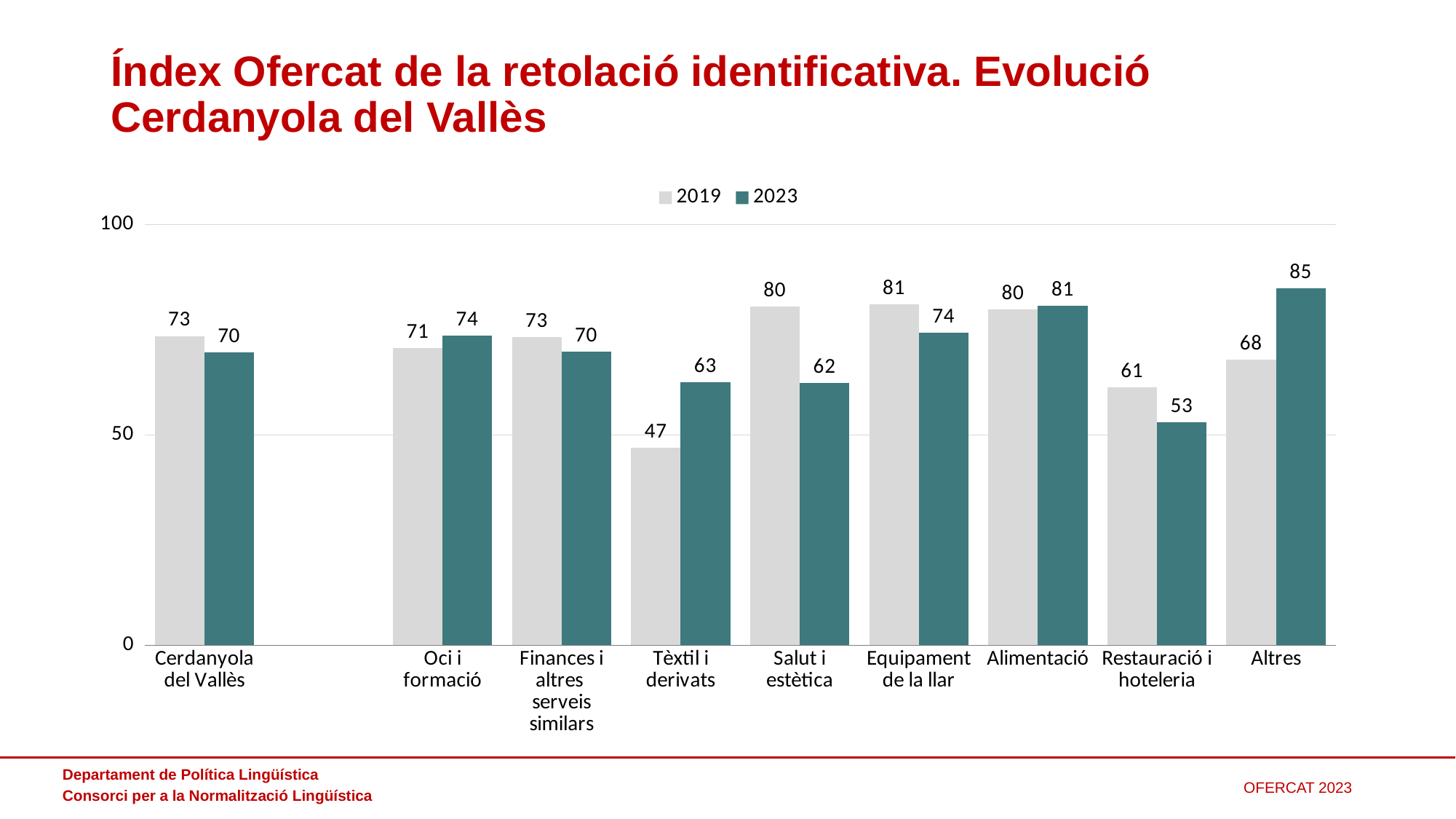
What is the 2019 value for Tèxtil i derivats? 47 What is the difference between the 2019 and 2023 values for Salut i estètica? 18 How many series does the legend list? 2 What kind of chart is shown on the slide? Bar chart Is the 2019 value for Tèxtil i derivats greater or less than 50? less Which is larger for Oci i formació, the 2019 value or the 2023 value? 2023 How many categories are shown on the x axis? 9 Which category has the highest 2023 value? Altres What is the 2023 value for Altres? 85 What is the 2023 value for Restauració i hoteleria? 53 Which category has the lowest 2019 value? Tèxtil i derivats Which series is shown in dark teal? 2023